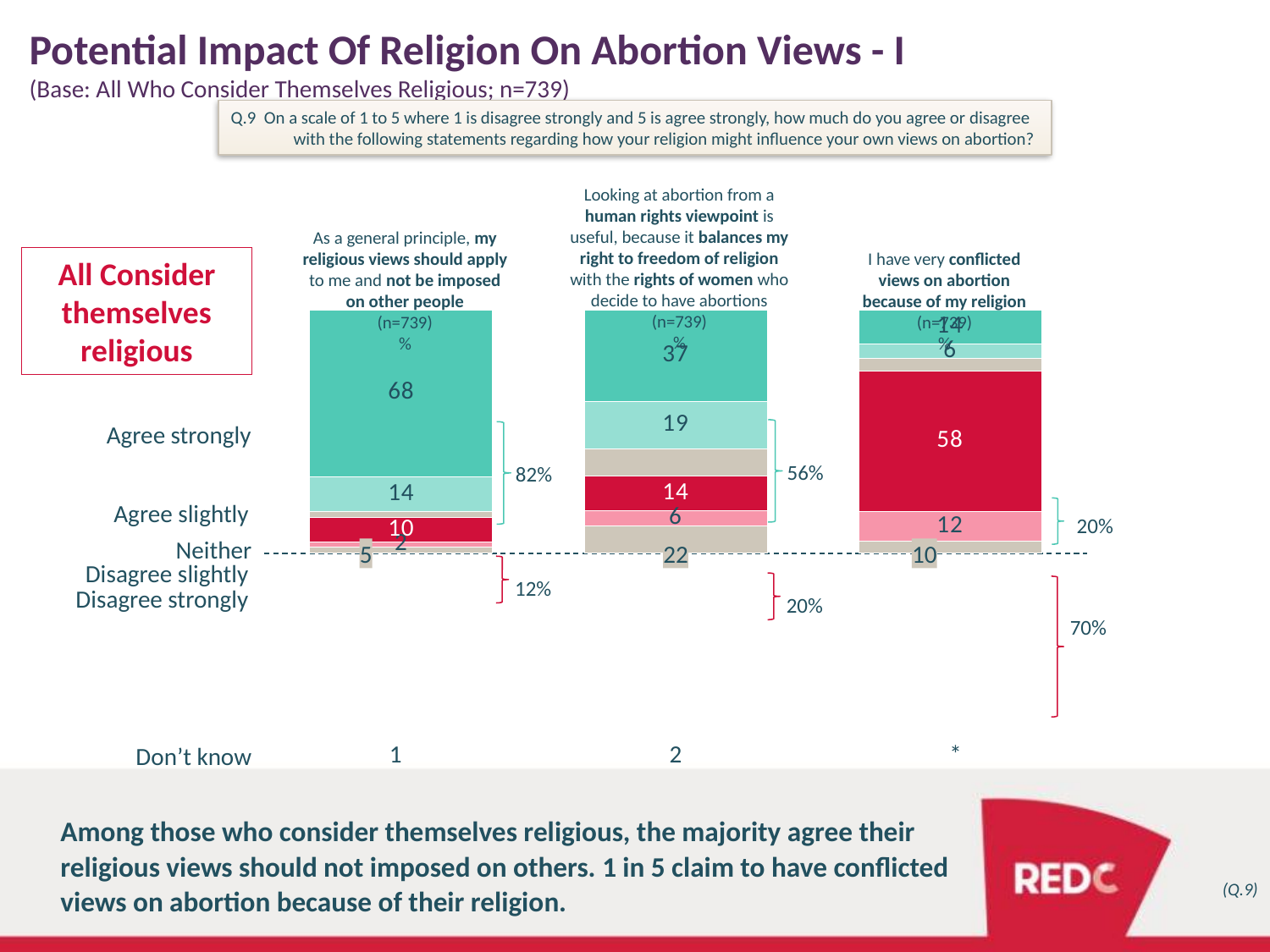
What is the difference between the 'Agree strongly' percentages for the 'not be imposed on other people' statement and the 'human rights viewpoint' statement? 31 What is the combined agree (strongly plus slightly) percentage shown for the statement about religious views not being imposed on other people? 82% What is the 'Don't know' value for the human rights viewpoint statement? 2 What percentage agree strongly that they have very conflicted views on abortion because of their religion? 14 What is the combined agree percentage shown for the human rights viewpoint statement? 56% What percentage agree strongly that their religious views should apply to them and not be imposed on other people? 68 What is the base size (n) shown for the chart? n=739 What percentage agree strongly that looking at abortion from a human rights viewpoint is useful? 37 Which statement has the highest 'Agree strongly' percentage? My religious views should apply to me and not be imposed on other people What kind of chart is shown on the slide? Stacked bar chart What is the combined disagree percentage shown for the statement about having conflicted views on abortion because of religion? 70% How many statements (bars) are plotted in the chart? 3